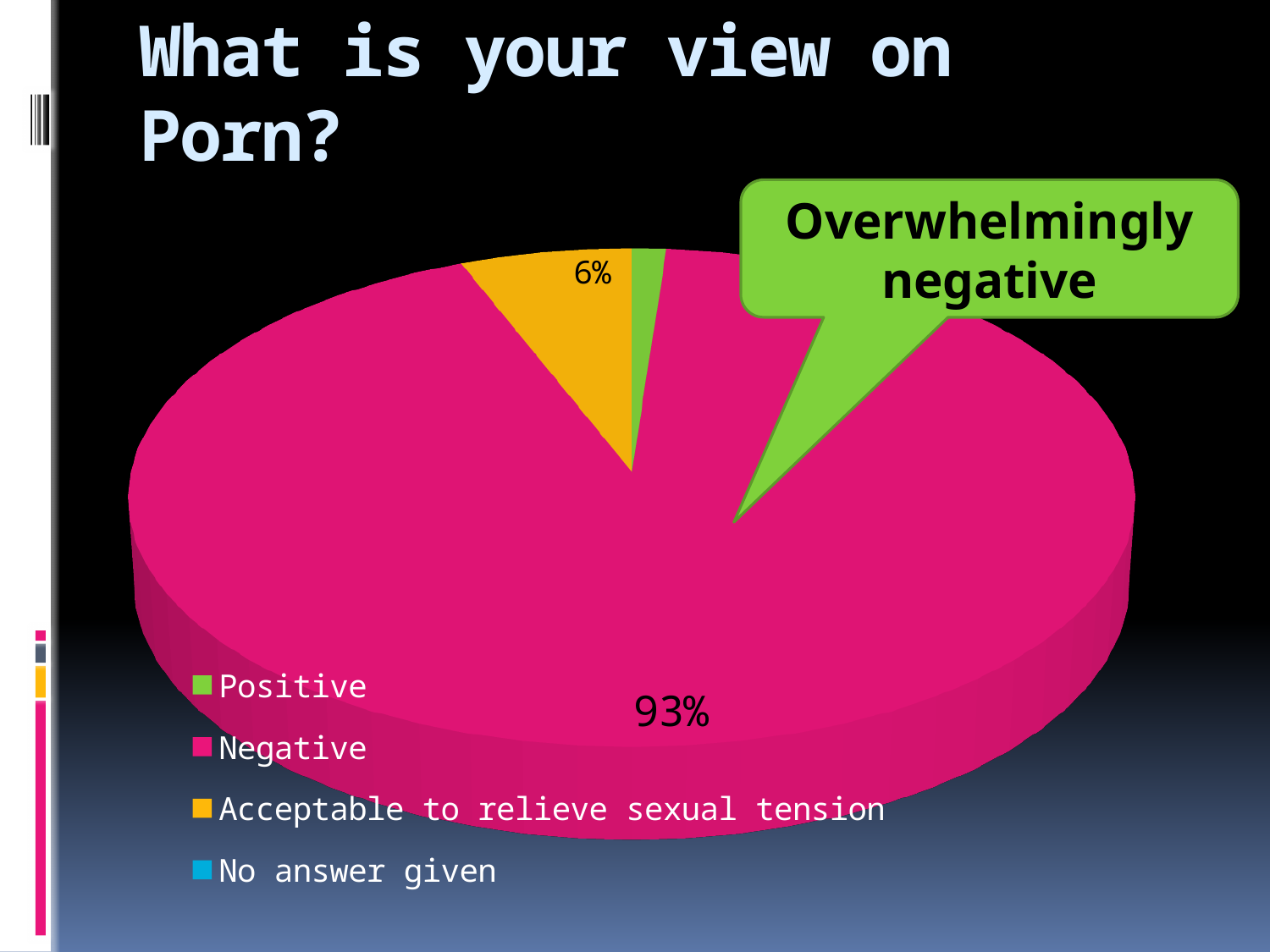
How many categories does the legend list? 4 What kind of chart is shown on the slide? Pie chart What share of the pie does the Negative slice represent? 93% What is the difference in percentage points between the Negative slice (93%) and the 'Acceptable to relieve sexual tension' slice (6%)? 87 percentage points Which category has the largest share of the pie chart? Negative What percentage is shown for the 'Acceptable to relieve sexual tension' slice? 6% What does the green callout box on the chart say? Overwhelmingly negative What is the title of the chart on the slide? What is your view on Porn? What percentage of the pie chart is labelled for the Negative slice? 93% Which is larger, the Negative slice or the 'Acceptable to relieve sexual tension' slice? Negative